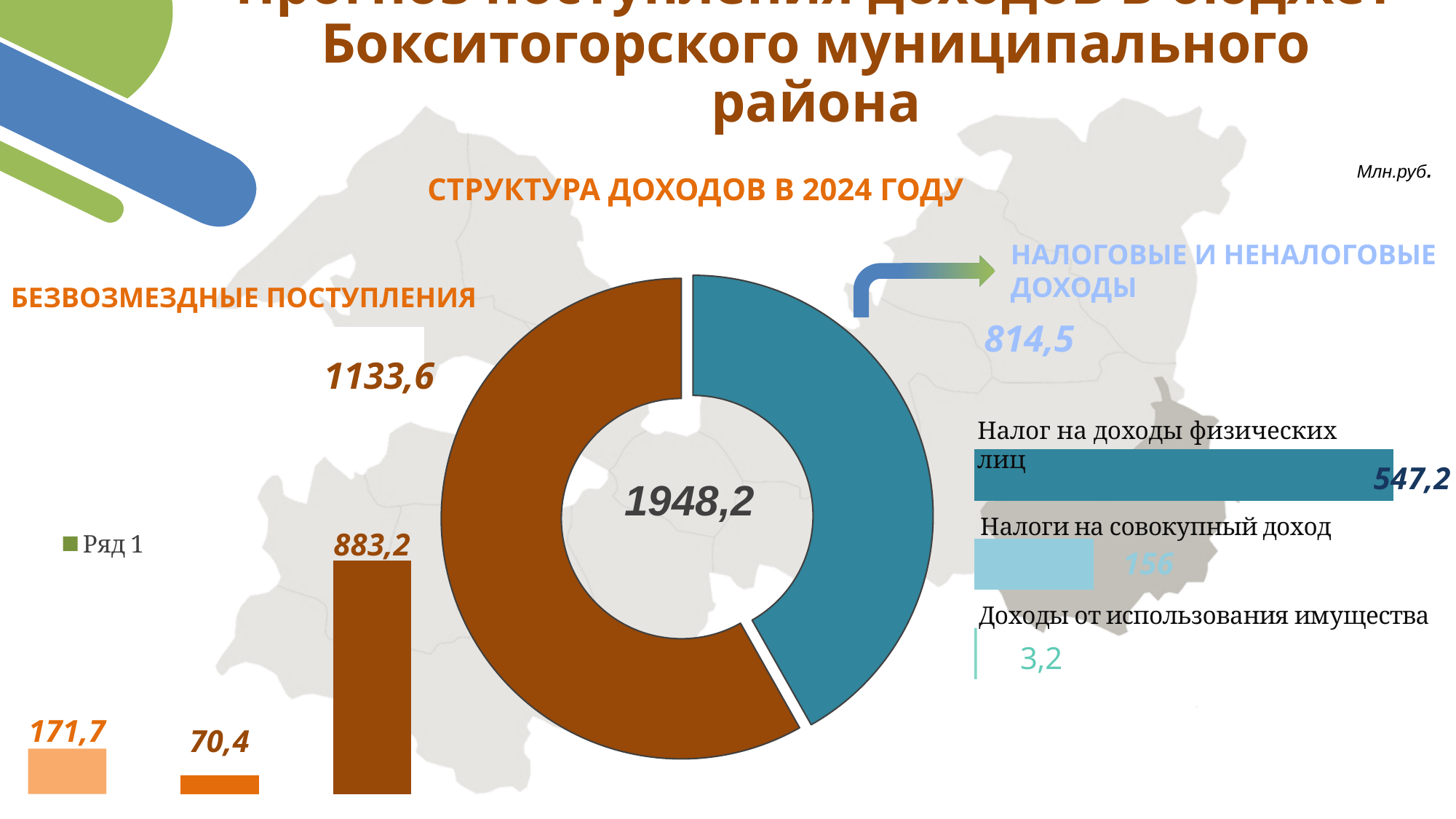
In the horizontal bar chart on the right of the slide, what is the difference between 'Налог на доходы физических лиц' and 'Налоги на совокупный доход'? 391,2 In the donut chart titled 'СТРУКТУРА ДОХОДОВ В 2024 ГОДУ', which segment is larger: 'БЕЗВОЗМЕЗДНЫЕ ПОСТУПЛЕНИЯ' or 'НАЛОГОВЫЕ И НЕНАЛОГОВЫЕ ДОХОДЫ'? БЕЗВОЗМЕЗДНЫЕ ПОСТУПЛЕНИЯ In the horizontal bar chart on the right of the slide, which category has the lowest value? Доходы от использования имущества In the donut chart titled 'СТРУКТУРА ДОХОДОВ В 2024 ГОДУ', what total is shown in the centre of the donut? 1948,2 In the horizontal bar chart on the right of the slide, what is the value for 'Налоги на совокупный доход'? 156 In the vertical bar chart on the left of the slide, what is the highest value shown? 883,2 In the donut chart titled 'СТРУКТУРА ДОХОДОВ В 2024 ГОДУ', what is the difference between 'БЕЗВОЗМЕЗДНЫЕ ПОСТУПЛЕНИЯ' and 'НАЛОГОВЫЕ И НЕНАЛОГОВЫЕ ДОХОДЫ'? 319,1 In the horizontal bar chart on the right of the slide, what is the value for 'Налог на доходы физических лиц'? 547,2 In the donut chart titled 'СТРУКТУРА ДОХОДОВ В 2024 ГОДУ', what is the value for 'НАЛОГОВЫЕ И НЕНАЛОГОВЫЕ ДОХОДЫ'? 814,5 In the donut chart titled 'СТРУКТУРА ДОХОДОВ В 2024 ГОДУ', what is the value for 'БЕЗВОЗМЕЗДНЫЕ ПОСТУПЛЕНИЯ'? 1133,6 In the horizontal bar chart on the right of the slide, how many categories are shown? 3 In the vertical bar chart on the left of the slide, how many series does the legend list? 1